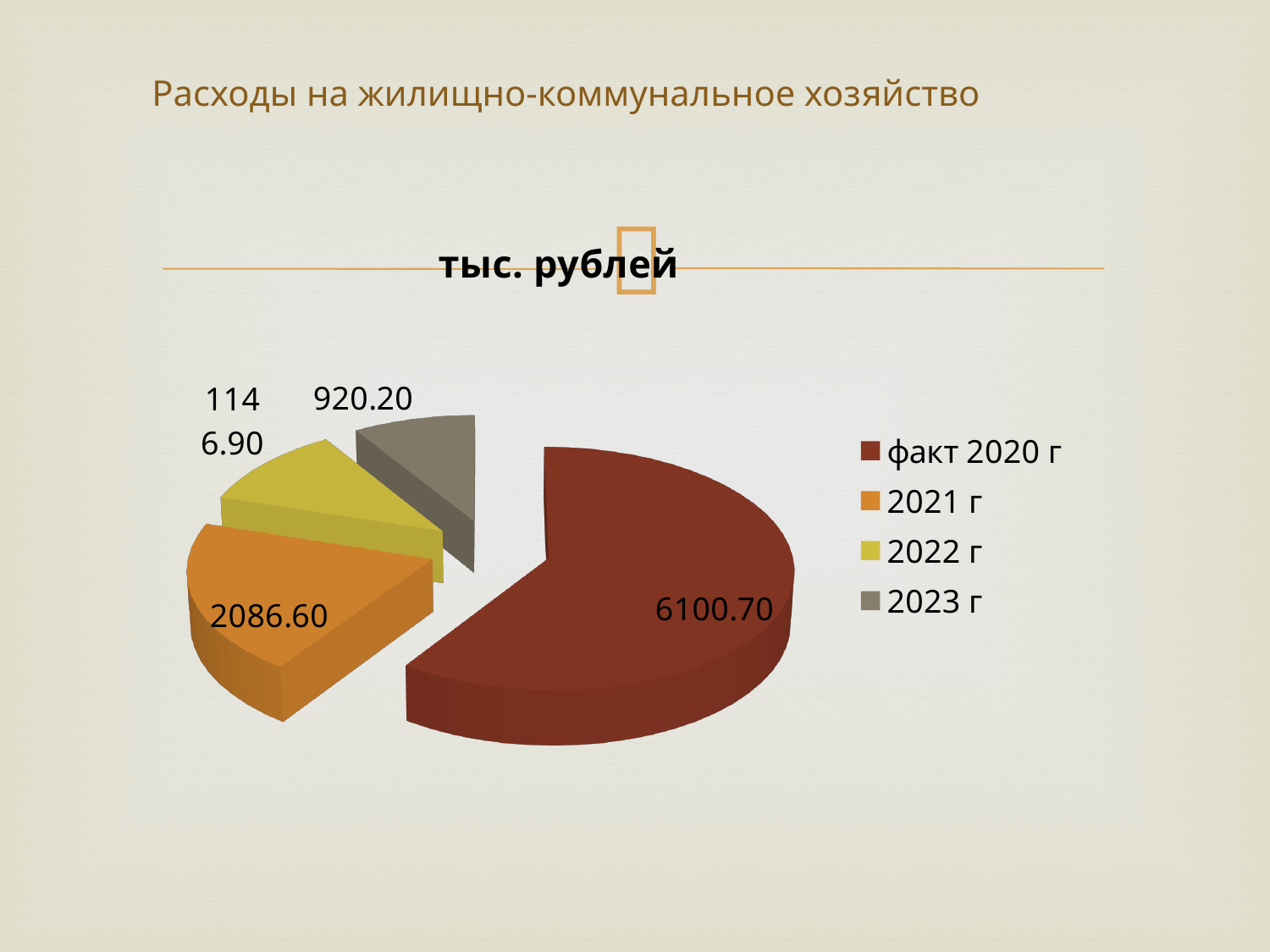
Which is larger, the value for 2021 г or the value for 2023 г? 2021 г What is the difference between the values for факт 2020 г and 2021 г? 4014.10 Which category has the largest slice of the pie? факт 2020 г How many slices does the pie chart have? 4 What is the title of the chart? тыс. рублей What kind of chart is shown on the slide? pie chart What is the difference between the values for 2021 г and 2023 г? 1166.40 What is the value for 2023 г? 920.20 Which category has the smallest slice of the pie? 2023 г How many entries does the legend list? 4 What is the value for 2021 г? 2086.60 What is the value for факт 2020 г? 6100.70